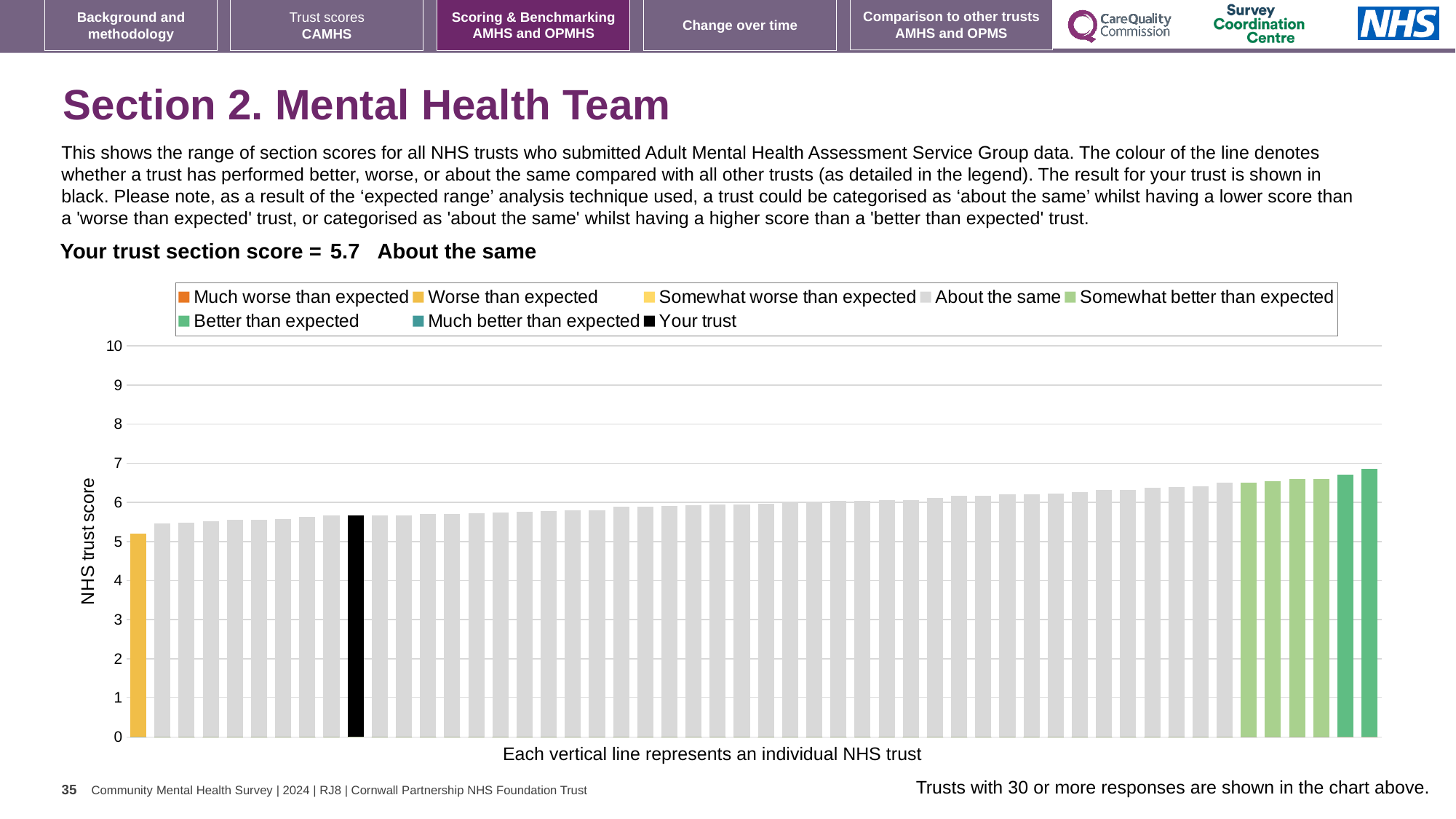
Is the value of the leftmost (yellow) bar greater or less than 6? less Is the value of the black 'Your trust' bar greater or less than 5? greater Which category is your trust's section score placed in? About the same How many bars are coloured as 'Somewhat better than expected' (light green)? 4 What colour is the bar representing your trust? black Is the value of the tallest bar in the chart greater or less than 6? greater How many bars are coloured as 'Better than expected' (green)? 2 What kind of chart is shown on the slide? bar chart How many entries does the chart legend list? 8 What is the section score for your trust? 5.7 Do the bar values rise or fall from left to right across the chart? rise What is the label on the vertical axis of the chart? NHS trust score